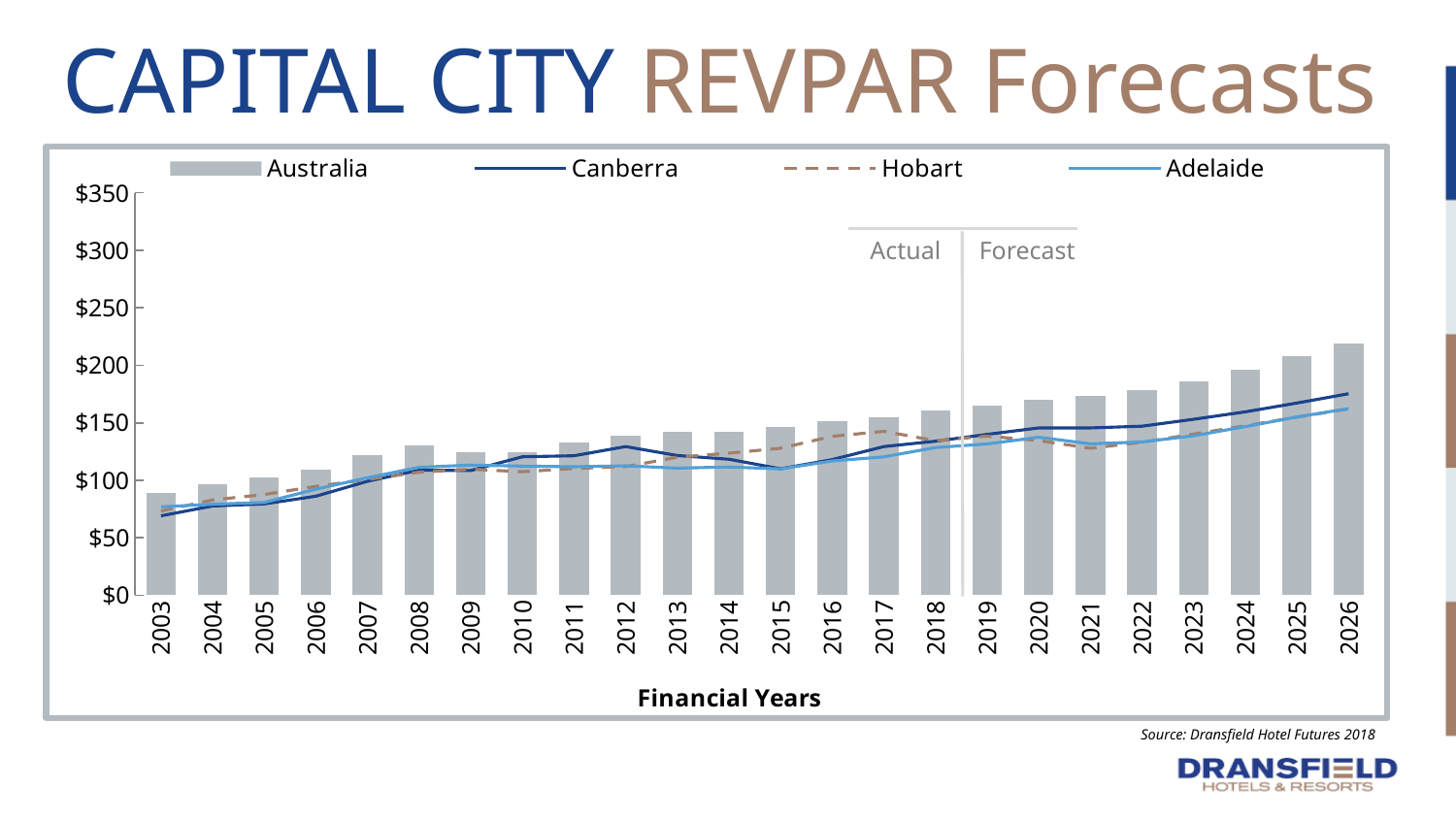
Is the value for Australia in 2026 greater or less than $200? greater Which series is plotted as bars? Australia In which financial year is the Australia bar highest? 2026 Which is larger in 2021, the Canberra value or the Hobart value? Canberra What kind of chart is this? Combination bar and line chart What is the title of the x axis? Financial Years How many series does the legend list? 4 How many financial years are shown on the x axis? 24 Is the value for Canberra in 2026 greater or less than $150? greater Do the Australia bars generally rise or fall from 2003 to 2026? rise In which financial year is the Australia bar lowest? 2003 Is the value for Australia in 2003 greater or less than $100? less